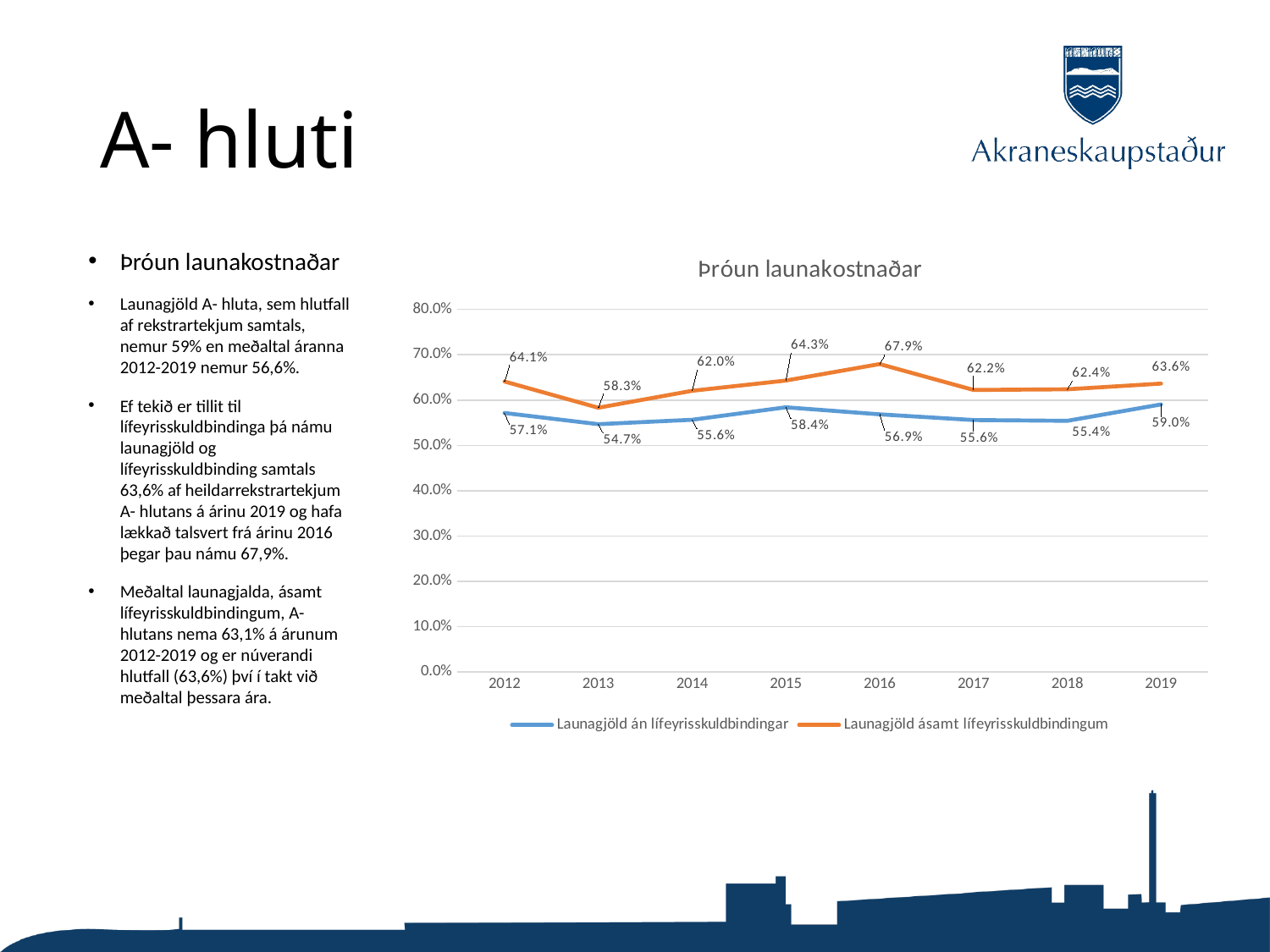
What is the value for Launagjöld án lífeyrisskuldbindingar in 2019? 59.0% Which is larger: Launagjöld ásamt lífeyrisskuldbindingum in 2012 or in 2019? 2012 What is the difference between Launagjöld ásamt lífeyrisskuldbindingum and Launagjöld án lífeyrisskuldbindingar in 2016? 11.0% What is the value for Launagjöld án lífeyrisskuldbindingar in 2013? 54.7% What is the value for Launagjöld ásamt lífeyrisskuldbindingum in 2016? 67.9% How many series does the legend list? 2 What type of chart is shown on the slide? Line chart What is the title of the chart? Þróun launakostnaðar How many years are shown on the x axis? 8 In which year is Launagjöld án lífeyrisskuldbindingar lowest? 2013 Is the value for Launagjöld án lífeyrisskuldbindingar in 2015 greater or less than 60.0%? less In which year is Launagjöld ásamt lífeyrisskuldbindingum highest? 2016